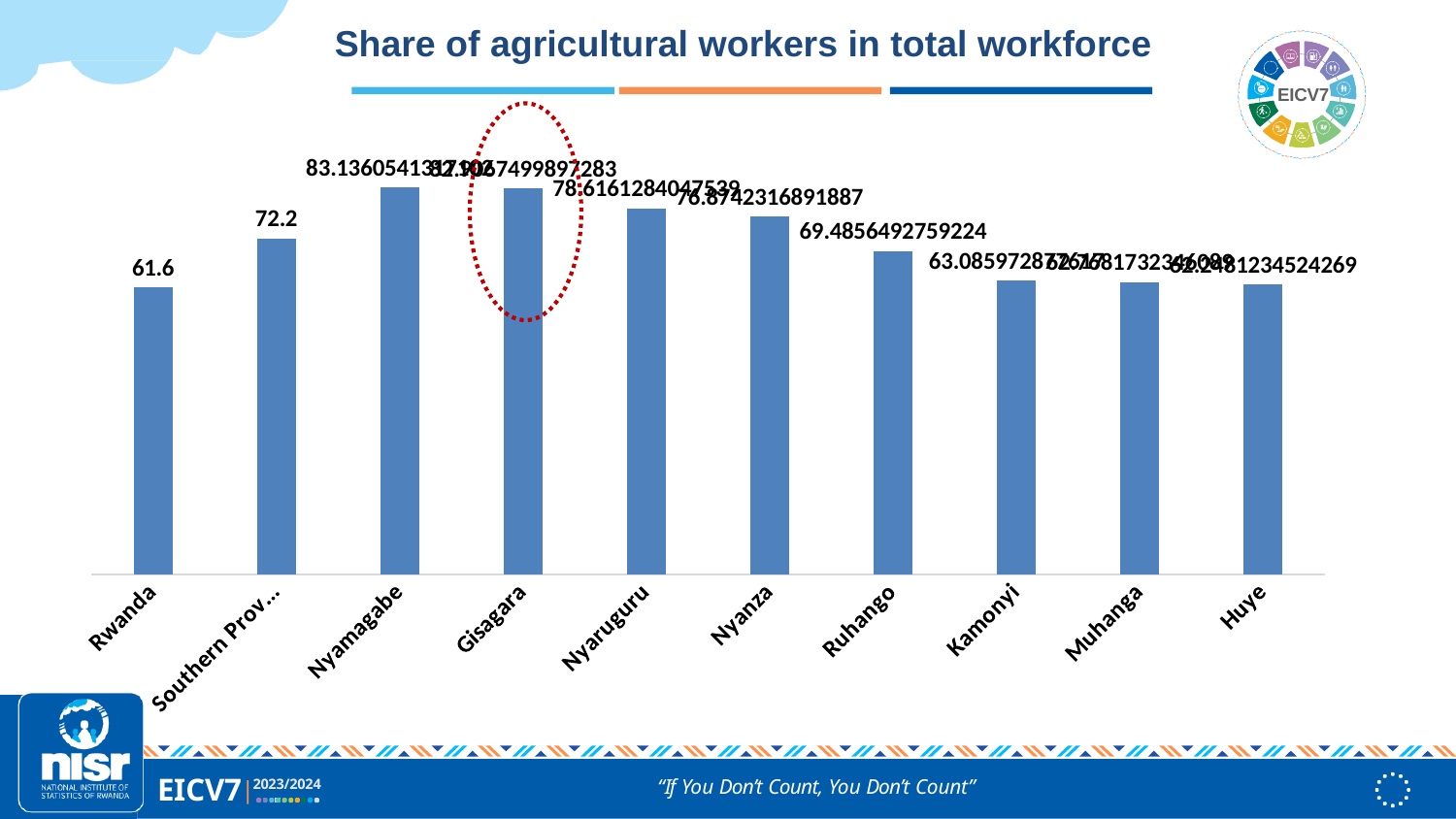
What is the value for Southern Prov...? 72.2 Which category's bar is highlighted with a red dotted circle? Gisagara What is the value for Nyaruguru? 78.6161284047539 What is the difference between the values for Southern Prov... and Rwanda? 10.6 What kind of chart is shown on the slide? Bar chart Which is larger, the value for Southern Prov... or the value for Rwanda? Southern Prov... Which is larger, the value for Nyaruguru or the value for Ruhango? Nyaruguru Which is larger, the value for Nyanza or the value for Kamonyi? Nyanza What is the title of the chart? Share of agricultural workers in total workforce How many categories are shown on the x axis? 10 What is the value for Rwanda? 61.6 What is the value for Ruhango? 69.4856492759224